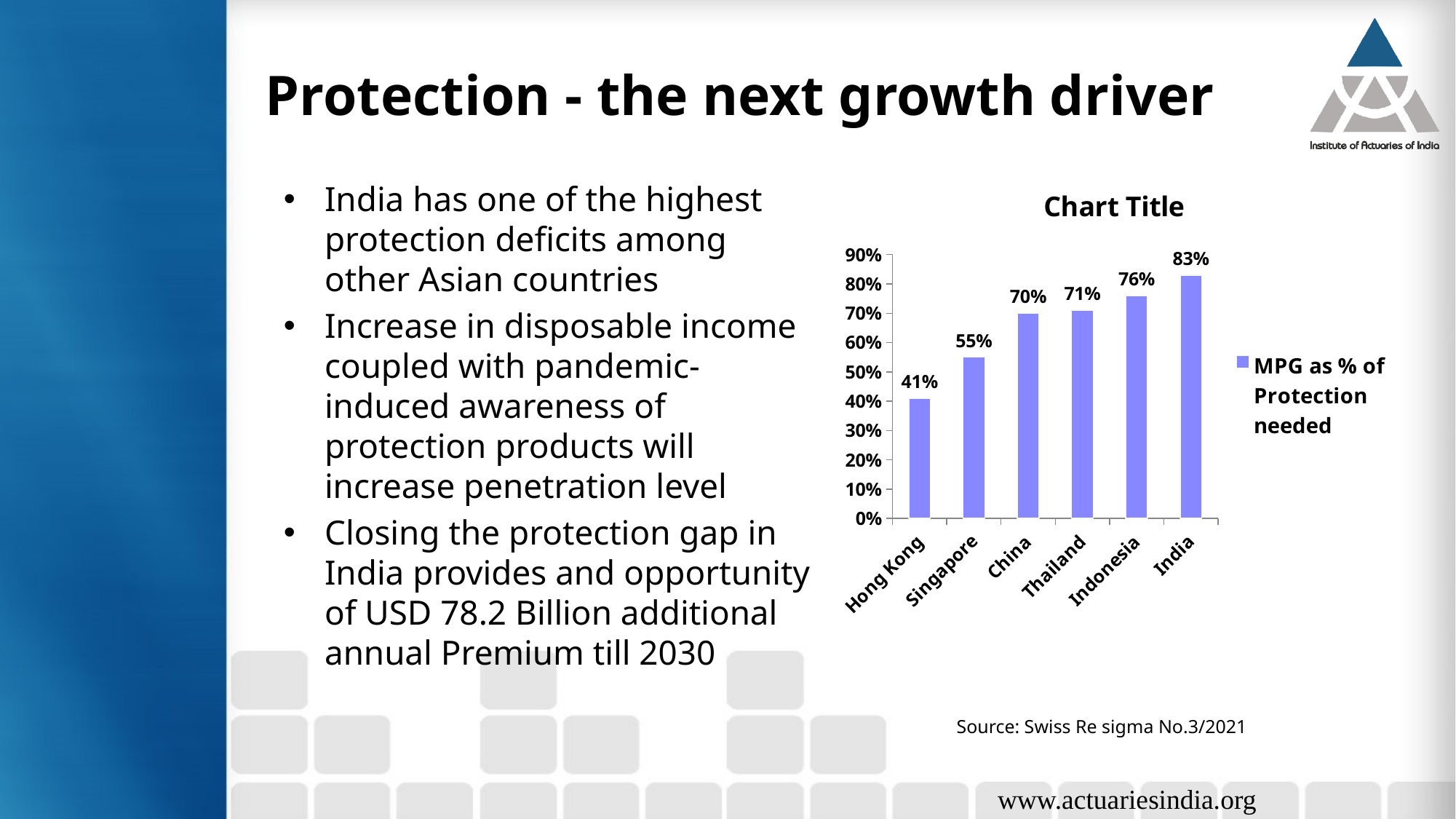
What is the value for India in the chart? 83% What is the difference between the values for India and Hong Kong? 42% What is the value for Hong Kong in the chart? 41% Which country has the lowest value in the chart? Hong Kong What kind of chart is shown on the slide? Bar chart Which has a larger value, Singapore or Thailand? Thailand Which country has the highest value in the chart? India How many series does the chart legend list? 1 How many countries are shown in the chart? 6 What is the value for Singapore in the chart? 55% What is the difference between the values for Indonesia and China? 6% What is the legend entry of the chart? MPG as % of Protection needed